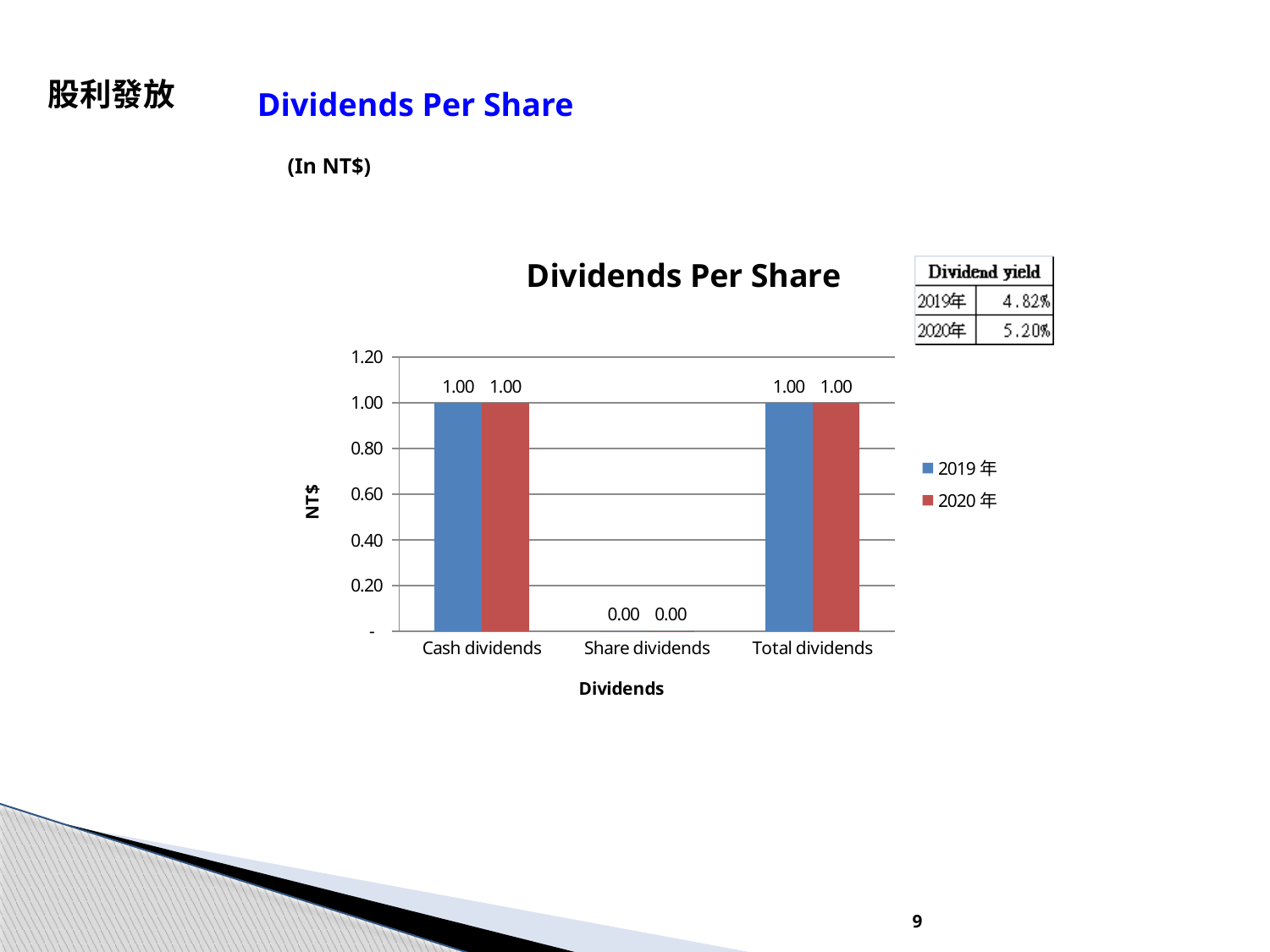
What is the difference between the 2019 年 values for Cash dividends and Share dividends? 1.00 What is the value for Cash dividends in the 2019 年 series? 1.00 Is the 2020 年 value for Cash dividends greater or less than 0.80? greater Which category has the lowest value in the 2019 年 series? Share dividends What kind of chart is shown on the slide? Bar chart What is the value for Total dividends in the 2020 年 series? 1.00 What is the label on the vertical axis of the chart? NT$ What is the difference between the 2019 年 and 2020 年 values for Total dividends? 0.00 What is the value for Share dividends in the 2020 年 series? 0.00 Is the 2019 年 value for Share dividends greater or less than 0.20? less How many series does the legend list? 2 How many categories are shown on the x axis of the chart? 3